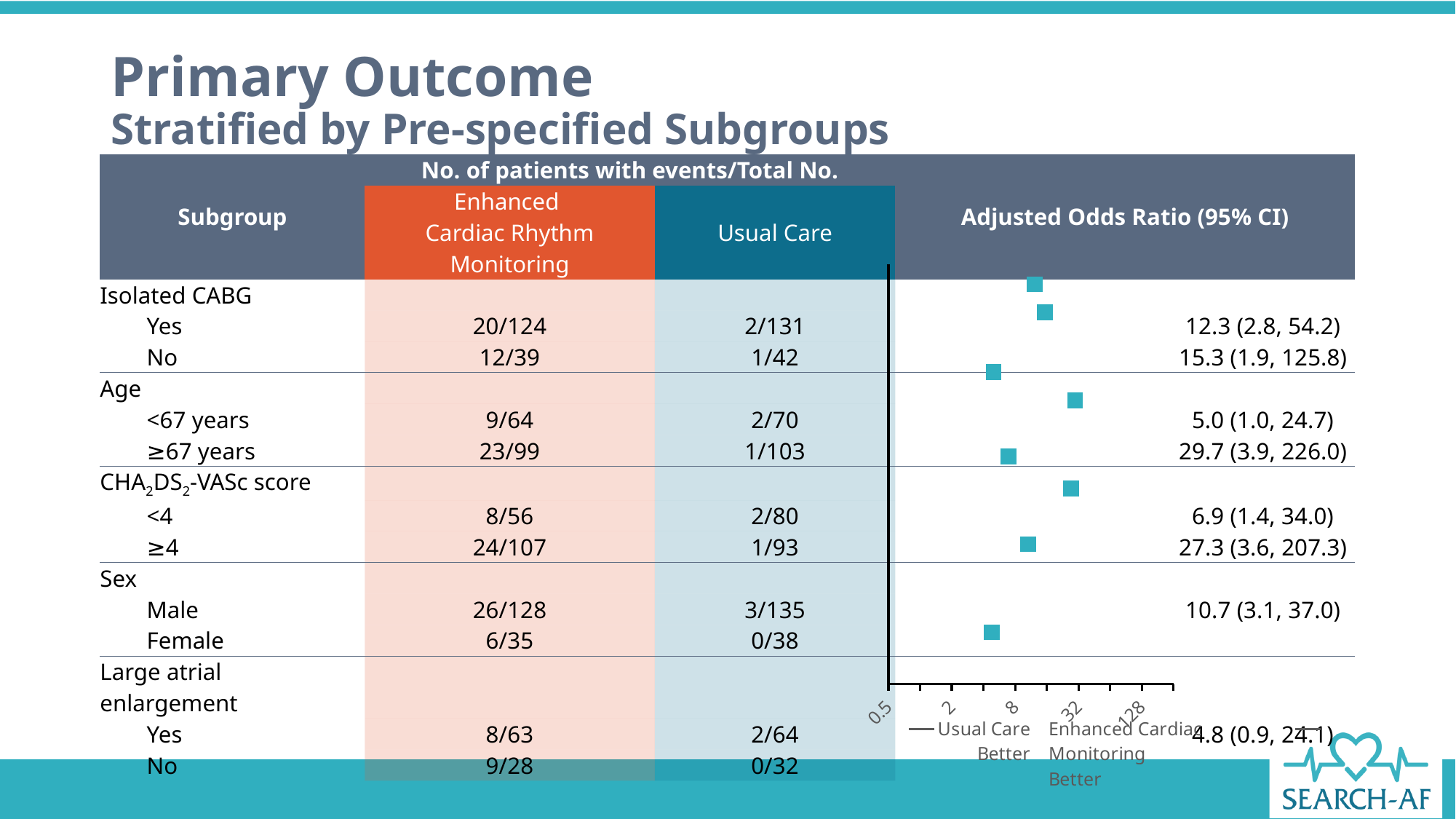
What is the adjusted odds ratio for the Isolated CABG 'Yes' subgroup? 12.3 Which side of the odds ratio axis is labelled 'Usual Care Better'? The left side What is the difference between the adjusted odds ratios for the ≥67 years and <67 years subgroups? 24.7 What is the adjusted odds ratio for patients aged ≥67 years? 29.7 What is the 95% confidence interval for the adjusted odds ratio in the Male subgroup? (3.1, 37.0) Which has a larger adjusted odds ratio: CHA2DS2-VASc score <4 or ≥4? ≥4 What are the tick values shown on the odds ratio axis? 0.5, 2, 8, 32, 128 How many subgroup points are plotted in the forest plot? 8 Which subgroup has the lowest adjusted odds ratio? Large atrial enlargement Yes Is the adjusted odds ratio for the Male subgroup greater or less than 8? greater Which subgroup has the highest adjusted odds ratio? ≥67 years Are all plotted adjusted odds ratios greater or less than 2? greater